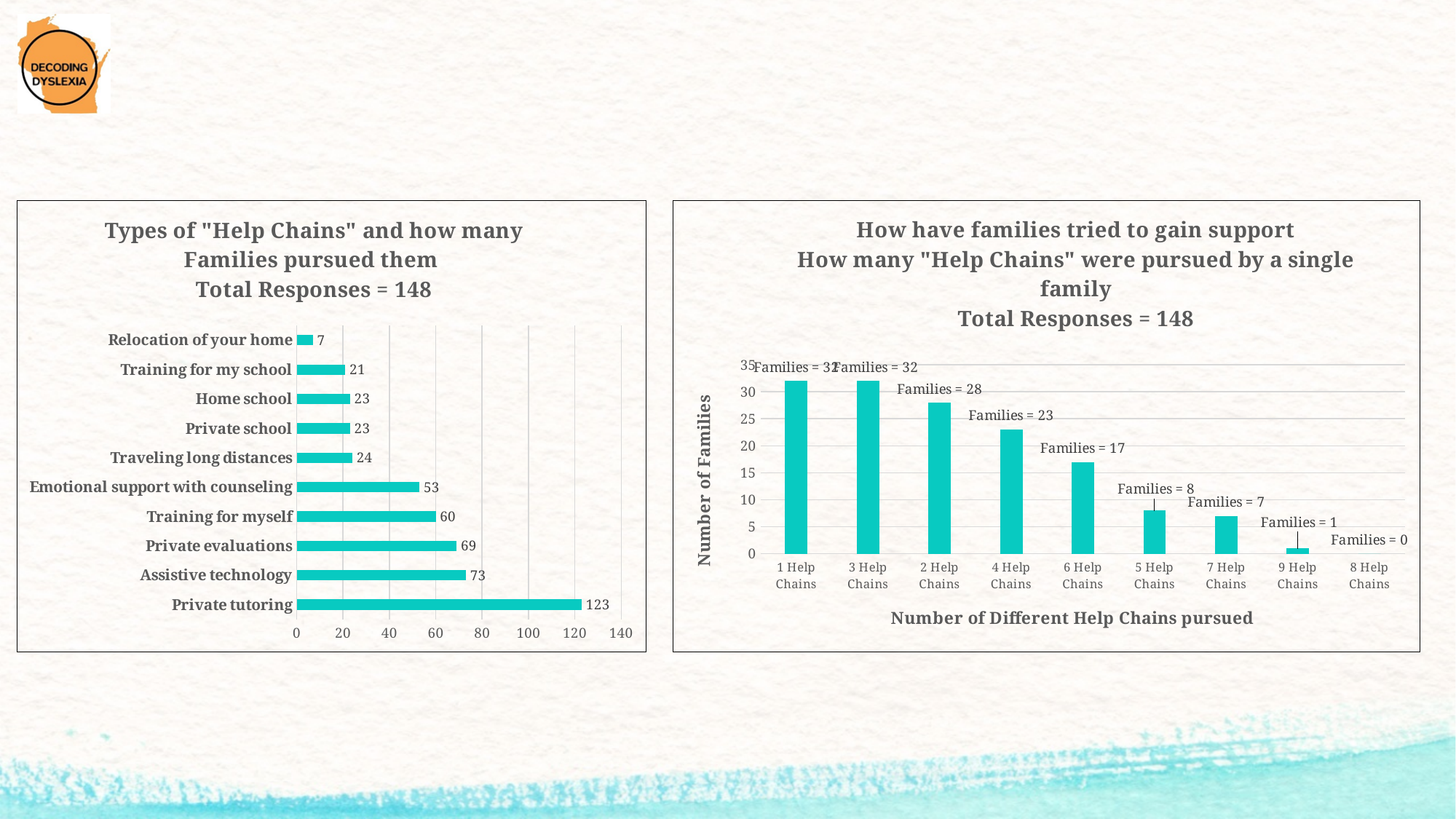
In the left chart, "Types of Help Chains", how many categories are shown? 10 In the left chart, "Types of Help Chains", what is the value for Assistive technology? 73 In the left chart, "Types of Help Chains", which category has the lowest value? Relocation of your home In the right chart, "How have families tried to gain support", how many families pursued 6 Help Chains? 17 In the right chart, "How have families tried to gain support", how many categories are shown on the x axis? 9 What type of chart is the left chart, "Types of Help Chains"? Bar chart In the left chart, "Types of Help Chains", how many families pursued private tutoring? 123 In the left chart, "Types of Help Chains", which category has the highest value? Private tutoring In the left chart, "Types of Help Chains", what is the difference between Private evaluations and Training for myself? 9 In the right chart, "How have families tried to gain support", how many families pursued 2 Help Chains? 28 In the left chart, "Types of Help Chains", which is larger: Emotional support with counseling or Traveling long distances? Emotional support with counseling In the right chart, "How have families tried to gain support", what is the y-axis title? Number of Families